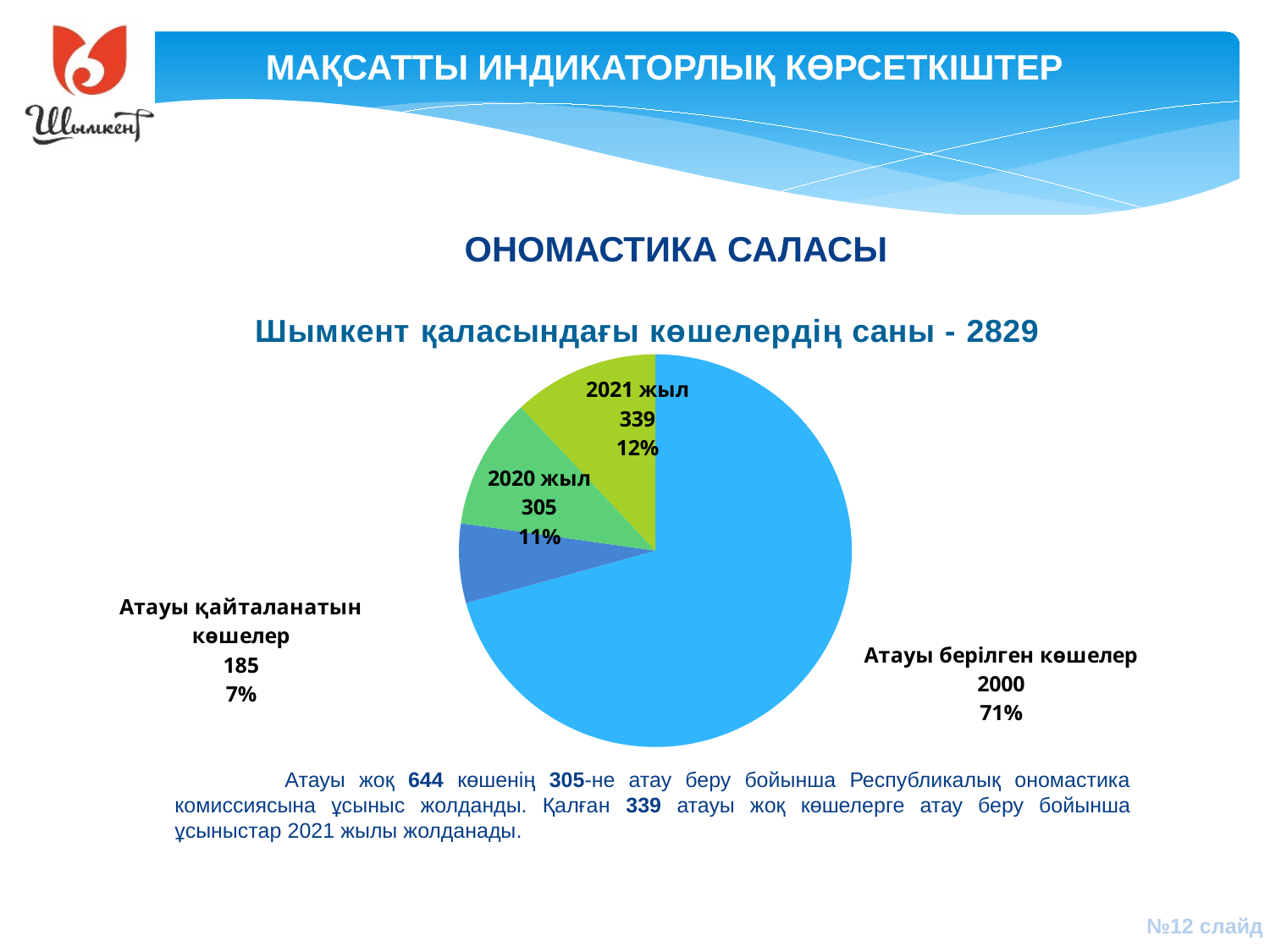
What is the value for "2021 жыл"? 339 What total number of streets is stated in the chart title? 2829 Which slice of the pie chart is the largest? Атауы берілген көшелер Which is larger, the value for "2020 жыл" or the value for "Атауы қайталанатын көшелер"? 2020 жыл What percentage is shown for "2020 жыл"? 11% What kind of chart is shown on the slide? pie chart What is the difference between the values for "2021 жыл" and "2020 жыл"? 34 Which slice of the pie chart is the smallest? Атауы қайталанатын көшелер How many slices does the pie chart have? 4 What share of the pie does "Атауы берілген көшелер" represent? 71% What is the value for "Атауы қайталанатын көшелер"? 185 What is the value for "Атауы берілген көшелер" in the pie chart? 2000